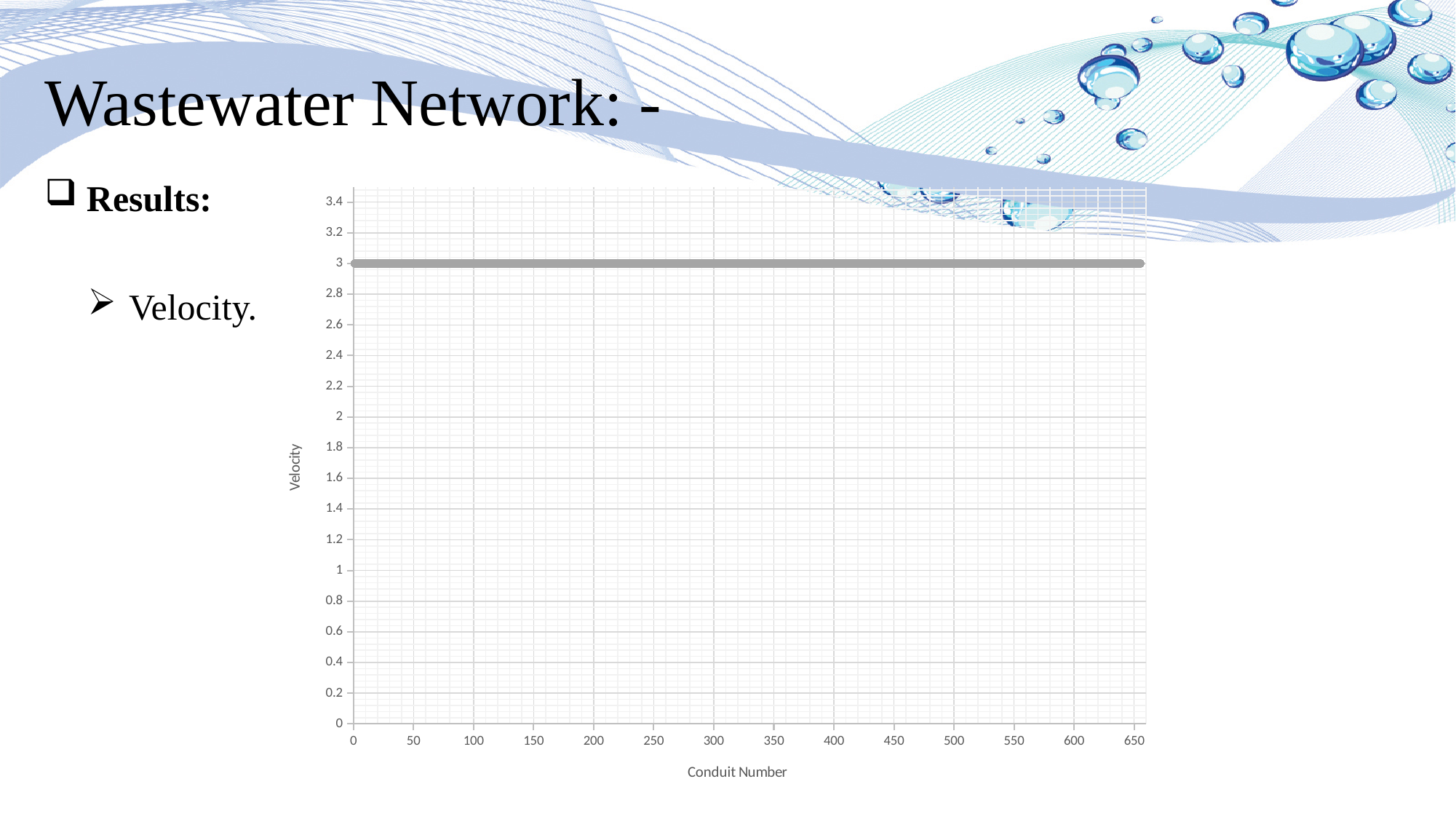
Do the plotted velocity values rise, fall, or stay constant as the conduit number increases? stay constant Is the velocity value at conduit number 500 greater or less than 3.2? less Is the velocity value at conduit number 100 greater or less than 2? greater What is the title of the vertical axis of the chart? Velocity At which velocity tick does the plotted line sit across all conduit numbers? 3 What is the title of the horizontal axis of the chart? Conduit Number What kind of chart is shown on the slide? line chart Is the velocity at conduit number 50 larger than, smaller than, or equal to the velocity at conduit number 600? equal What is the highest tick label shown on the vertical axis of the chart? 3.4 Is the velocity value at conduit number 300 greater or less than 1? greater